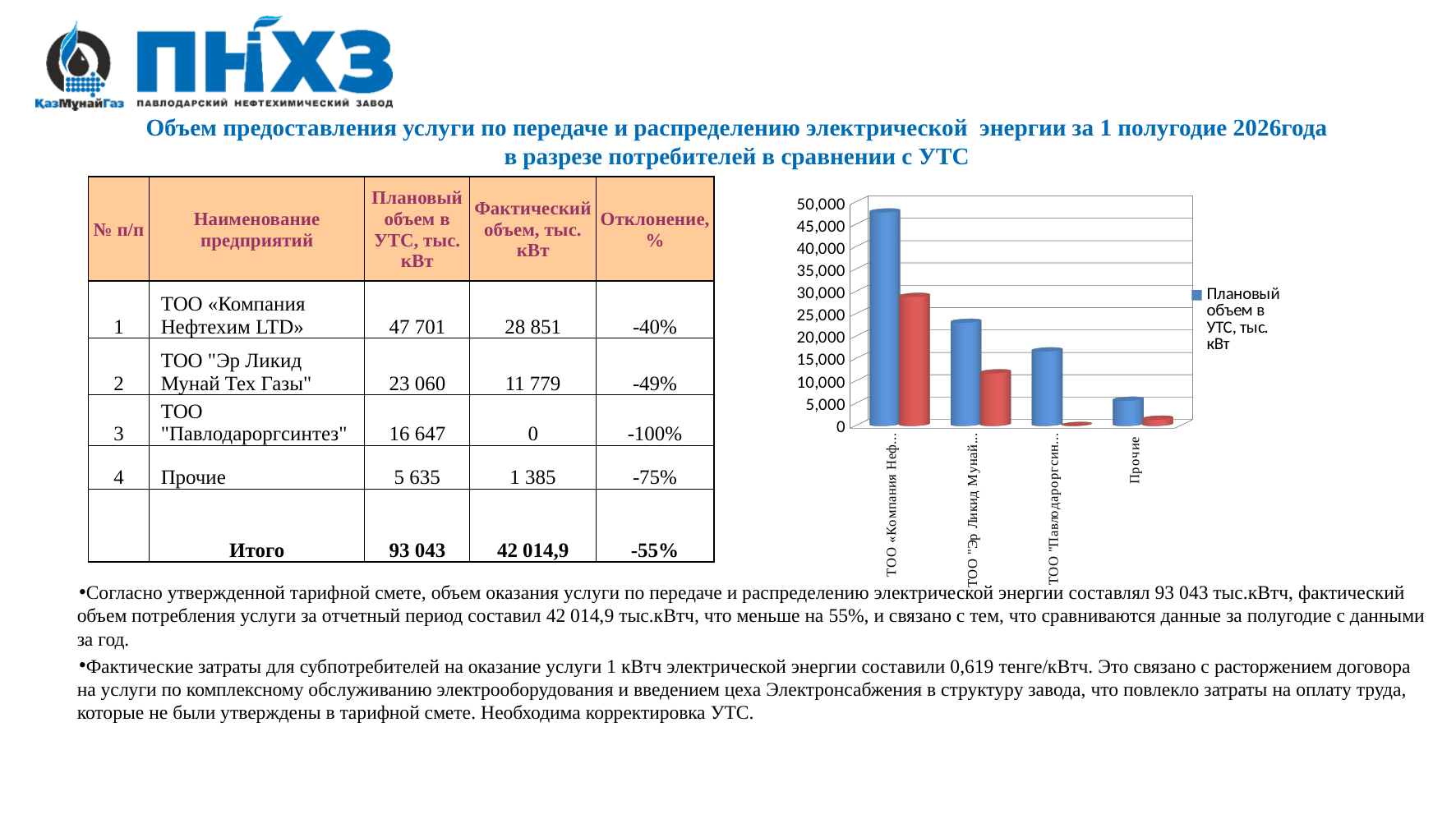
Is the red (actual) bar for ТОО "Эр Ликид Мунай Тех Газы" greater or less than 15,000? less Is the blue (planned) bar for ТОО «Компания Нефтехим LTD» greater or less than 45,000? greater By how much does the planned volume exceed the actual volume for ТОО «Компания Нефтехим LTD» (тыс. кВт)? 18 850 What legend entry is shown next to the chart? Плановый объем в УТС, тыс. кВт Is the blue (planned) bar for Прочие greater or less than 10,000? less Which category has the shortest blue (planned volume) bar in the chart? Прочие Which category has the tallest blue (planned volume) bar in the chart? ТОО «Компания Нефтехим LTD» For ТОО «Компания Нефтехим LTD», which bar is taller: the blue planned bar or the red actual bar? the blue planned bar How many categories (enterprises) are shown on the x axis of the chart? 4 What kind of chart is shown on the slide? bar chart What is the planned volume in УТС (тыс. кВт) for Прочие, as shown on the slide? 5 635 Do the blue (planned volume) bars rise or fall from left to right across the chart? fall